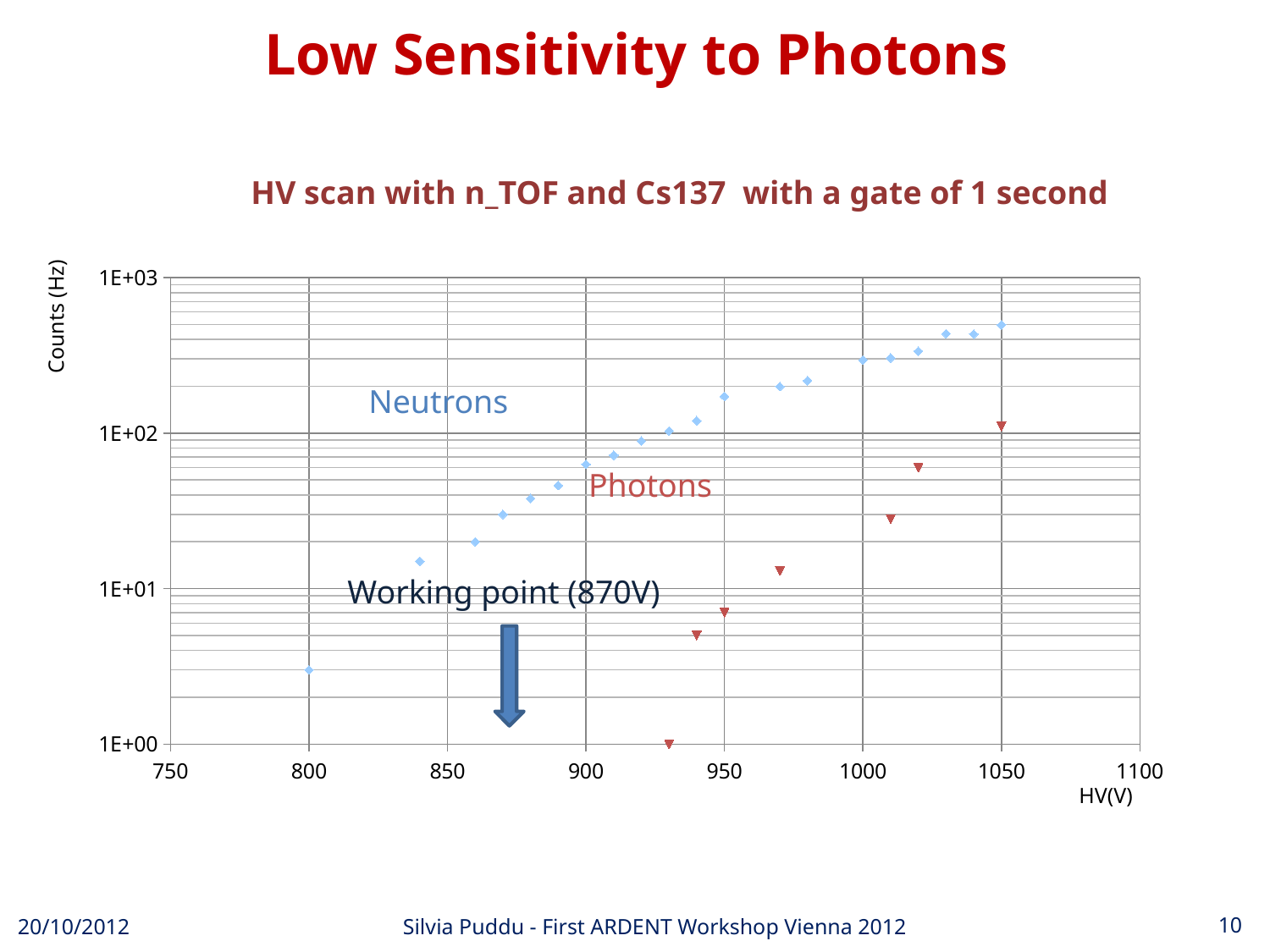
What is the title of the chart? HV scan with n_TOF and Cs137 with a gate of 1 second What kind of chart is shown on the slide? scatter chart At which HV value is the Neutrons count lowest? 800 At 1050 V, which series has the higher count rate, Neutrons or Photons? Neutrons Is the Neutrons value at 1000 V greater or less than 1E+02 Hz? greater Is the Photons value at 950 V greater or less than 1E+01 Hz? less Is the Neutrons value at 1050 V greater or less than 1E+02 Hz? greater Do the Neutrons counts rise or fall as HV increases? rise What working point voltage is marked on the chart? 870V At which HV value is the Neutrons count highest? 1050